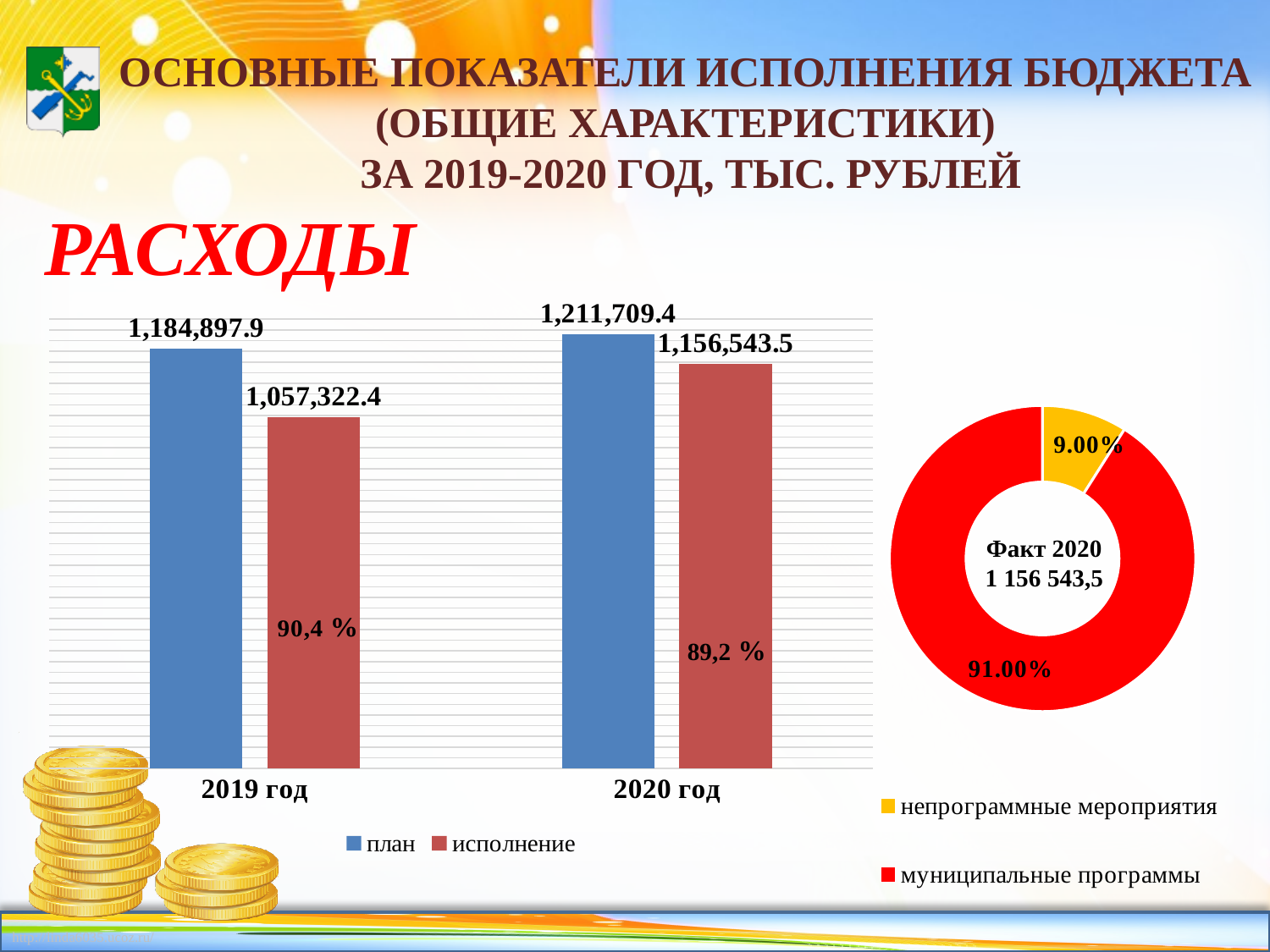
In the bar chart on the left, does the план value rise or fall from 2019 год to 2020 год? rise In the bar chart on the left, what percentage label is shown on the исполнение bar for 2020 год? 89,2 % In the bar chart on the left, how many series does the legend list? 2 In the bar chart on the left, which is larger: исполнение for 2019 год or исполнение for 2020 год? исполнение for 2020 год In the bar chart on the left, what is the value of план for 2019 год? 1,184,897.9 In the bar chart on the left, what is the value of исполнение for 2020 год? 1,156,543.5 In the bar chart on the left, which bar is the highest? план for 2020 год In the bar chart on the left, what is the value of исполнение for 2019 год? 1,057,322.4 In the bar chart on the left, what is the difference between план and исполнение for 2019 год? 127,575.5 In the bar chart on the left, which bar is the lowest? исполнение for 2019 год In the doughnut chart on the right, what share does непрограммные мероприятия have? 9.00% In the doughnut chart on the right, which category has the largest share? муниципальные программы